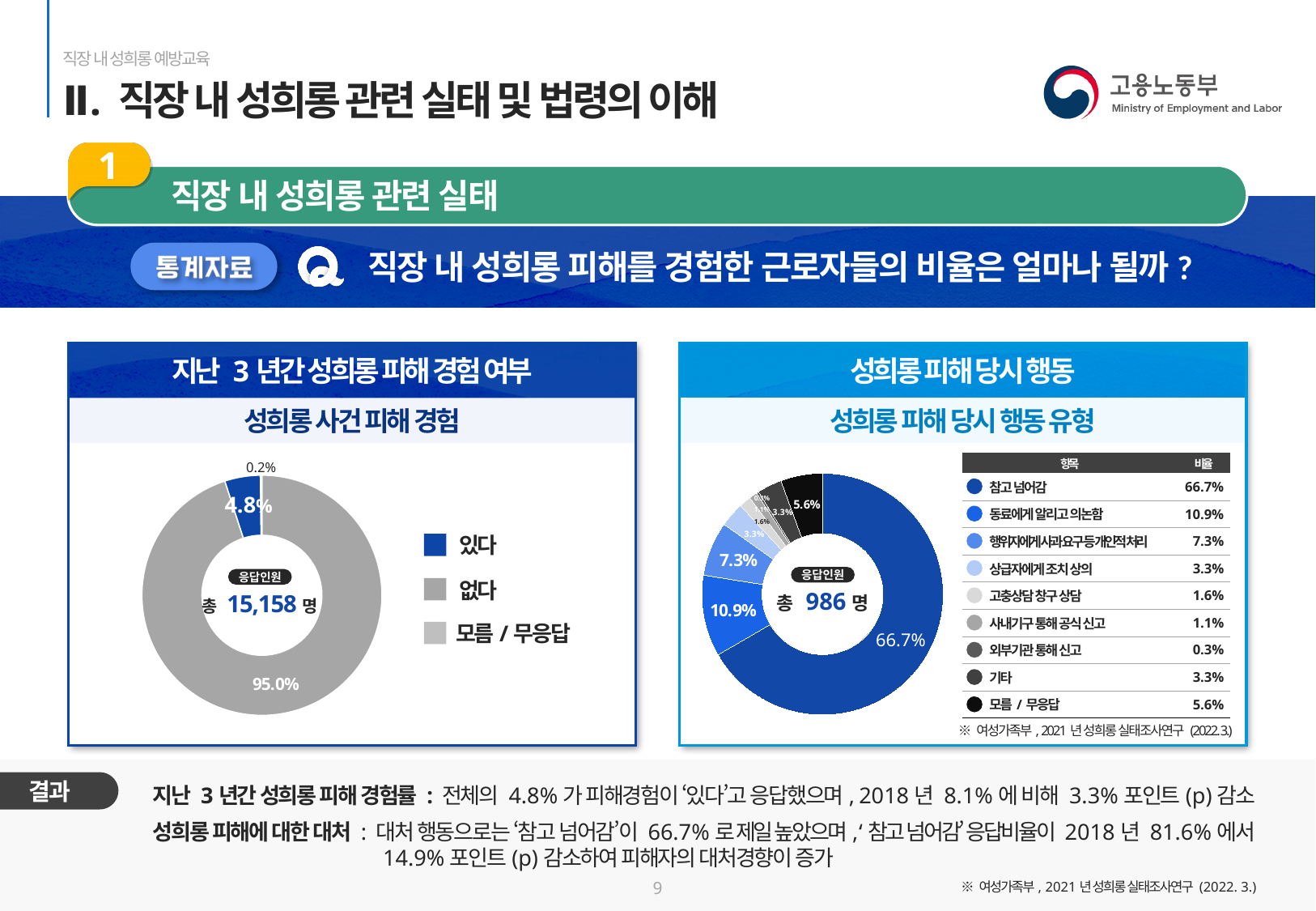
오른쪽 차트 '성희롱 피해 당시 행동'의 표에는 몇 개의 항목이 있는가? 9개 왼쪽 차트 '지난 3년간 성희롱 피해 경험 여부'에서 '모름 / 무응답'의 비율은 얼마인가? 0.2% 오른쪽 차트 '성희롱 피해 당시 행동'에서 '동료에게 알리고 의논함'의 비율은 얼마인가? 10.9% 오른쪽 차트 '성희롱 피해 당시 행동'에서 가장 비율이 높은 항목은 무엇인가? 참고 넘어감 왼쪽 차트 '지난 3년간 성희롱 피해 경험 여부'는 어떤 종류의 차트인가? 도넛(원형) 차트 왼쪽 차트 '지난 3년간 성희롱 피해 경험 여부'의 응답인원은 총 몇 명인가? 15,158명 왼쪽 차트 '지난 3년간 성희롱 피해 경험 여부'에서 '있다'의 비율은 얼마인가? 4.8% 오른쪽 차트 '성희롱 피해 당시 행동'에서 '참고 넘어감'과 '동료에게 알리고 의논함'의 비율 차이는 몇 퍼센트 포인트인가? 55.8%p 왼쪽 차트 '지난 3년간 성희롱 피해 경험 여부'에서 '없다'와 '있다'의 비율 차이는 몇 퍼센트 포인트인가? 90.2%p 오른쪽 차트 '성희롱 피해 당시 행동'에서 '모름 / 무응답'의 비율은 얼마인가? 5.6% 왼쪽 차트 '지난 3년간 성희롱 피해 경험 여부'에서 '없다'의 비율은 얼마인가? 95.0% 오른쪽 차트 '성희롱 피해 당시 행동'에서 가장 비율이 낮은 항목은 무엇인가? 외부기관 통해 신고